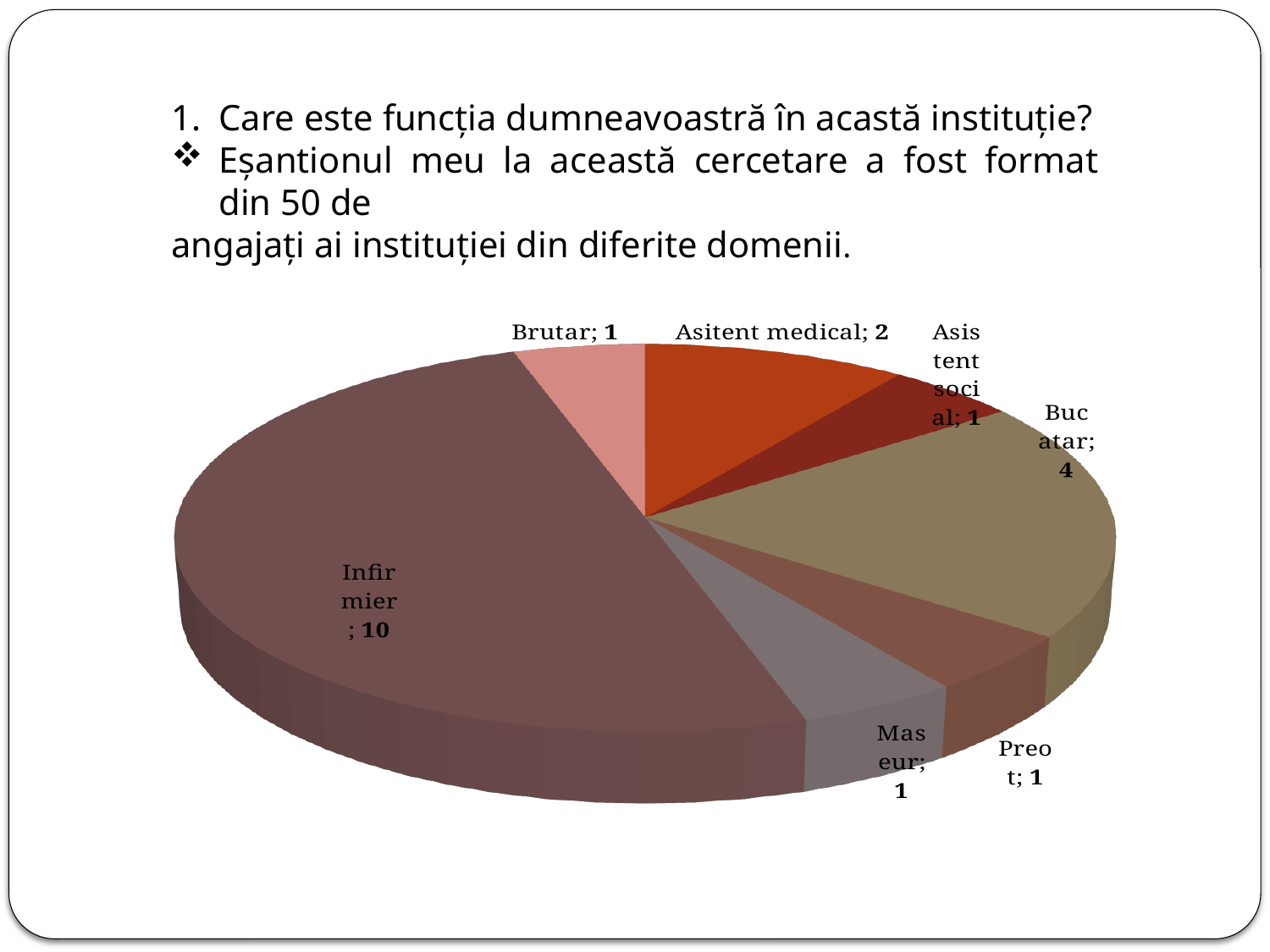
What kind of chart is shown on the slide? pie chart Which category has the largest slice in the pie chart? Infirmier What is the value for Bucatar in the pie chart? 4 What is the value for Asitent medical in the pie chart? 2 What is the difference between the values for Infirmier and Bucatar? 6 What is the value for Brutar in the pie chart? 1 What share of the pie does Infirmier represent? 50% What is the total of all the values shown in the pie chart? 20 What is the value for Infirmier in the pie chart? 10 Which is larger, the value for Bucatar or the value for Asitent medical? Bucatar How many slices does the pie chart have? 7 What share of the pie does Bucatar represent? 20%